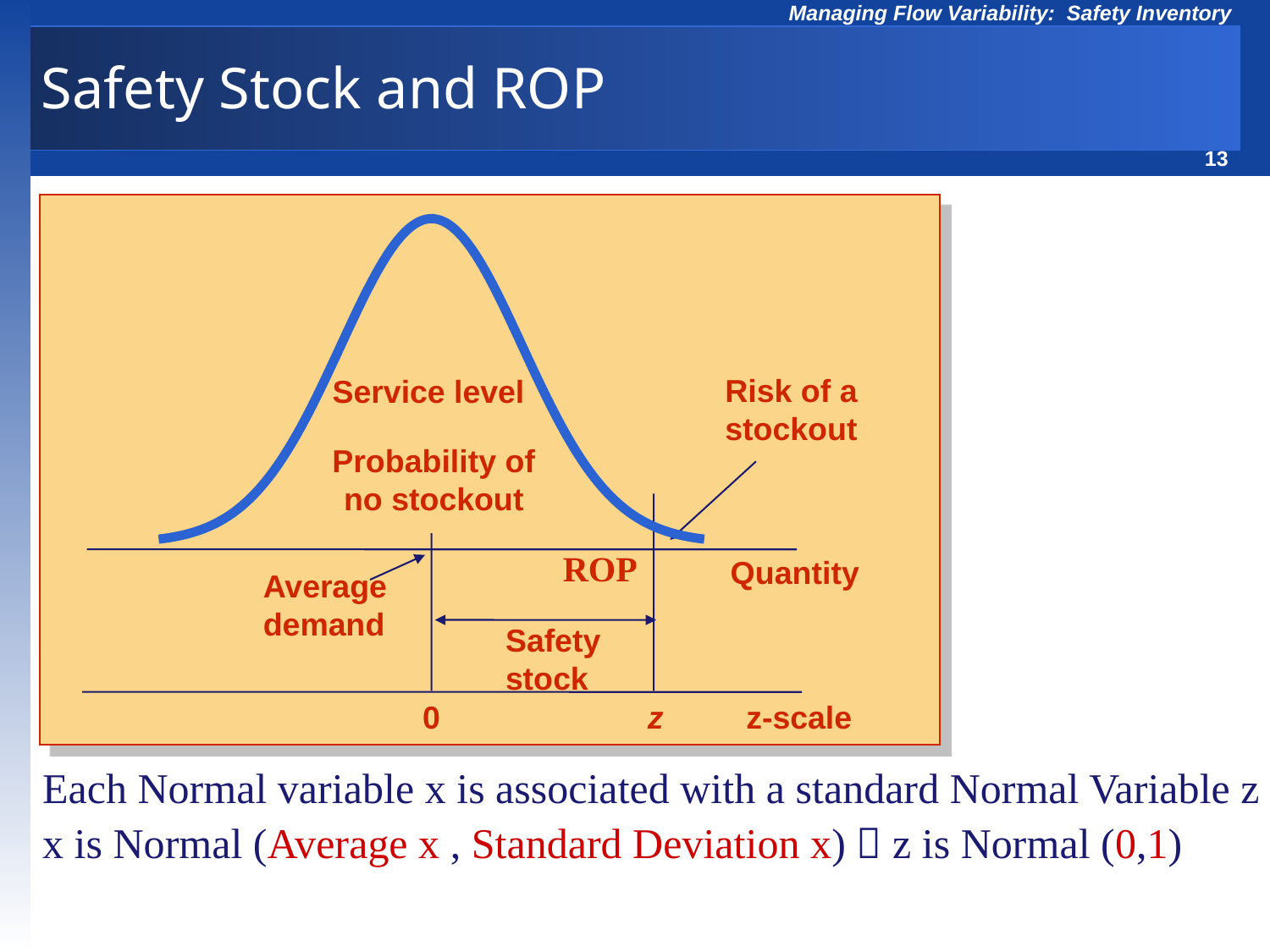
What is the label of the lower horizontal axis? z-scale What kind of chart is shown on the slide? A bell-shaped normal distribution curve What does the area under the curve to the left of ROP represent, according to the labels? Service level (probability of no stockout) What value is marked on the z-scale directly below the average demand? 0